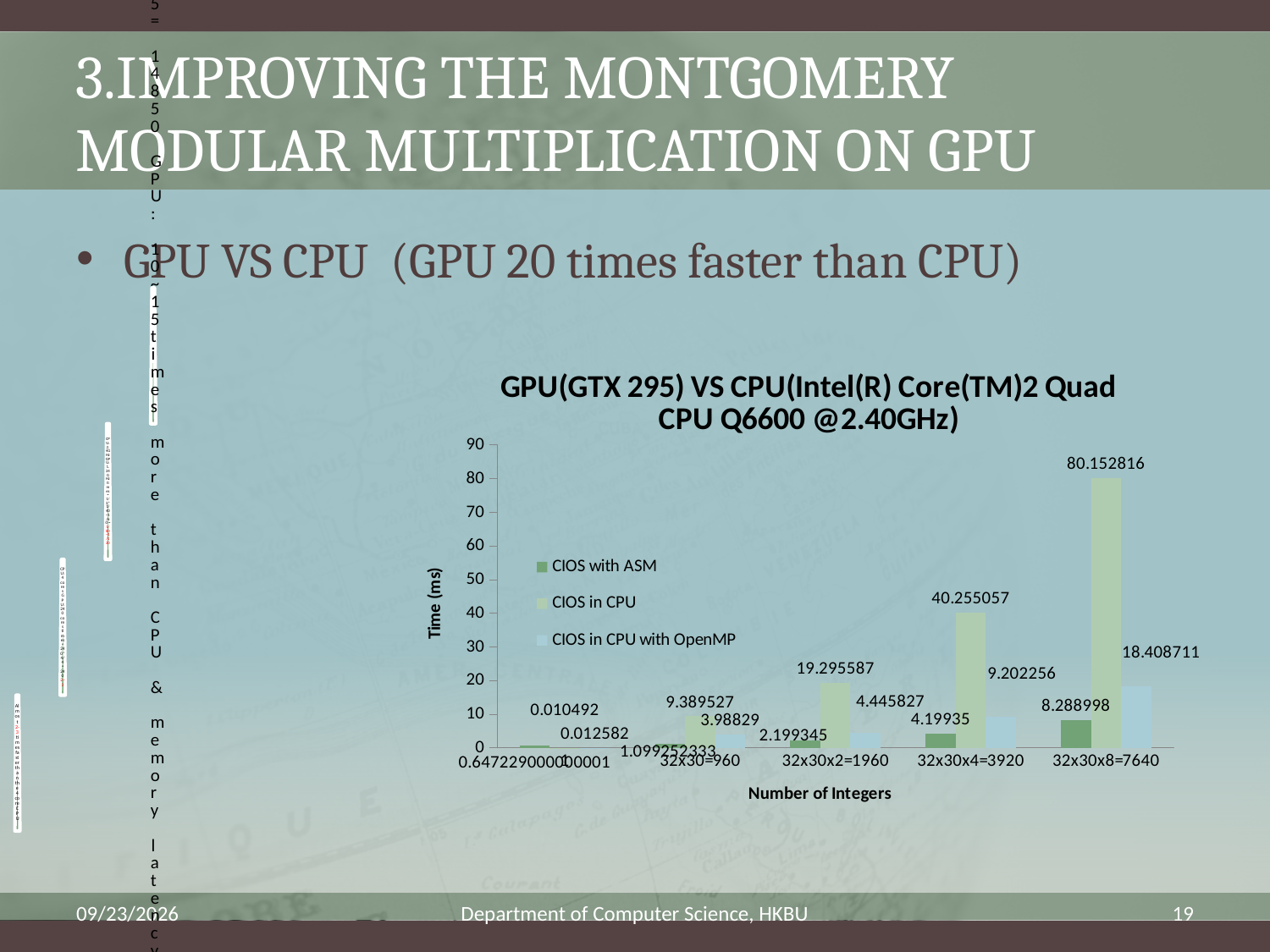
How many series does the chart legend list? 3 What is the value for CIOS with ASM at 32x30x4=3920? 4.19935 Is the value for CIOS in CPU at 32x30x4=3920 greater or less than 30? greater At 32x30=960, which is larger: CIOS in CPU or CIOS in CPU with OpenMP? CIOS in CPU What kind of chart is shown on the slide? Bar chart Do the values for CIOS in CPU rise or fall from 32x30=960 to 32x30x8=7640? Rise What is the value for CIOS in CPU with OpenMP at 32x30x2=1960? 4.445827 Which category has the highest value for CIOS in CPU? 32x30x8=7640 What is the difference between CIOS in CPU and CIOS in CPU with OpenMP at 32x30x8=7640? 61.744105 What is the value for CIOS in CPU at 32x30x8=7640? 80.152816 What is the title of the vertical axis? Time (ms) What is the title of the horizontal axis? Number of Integers